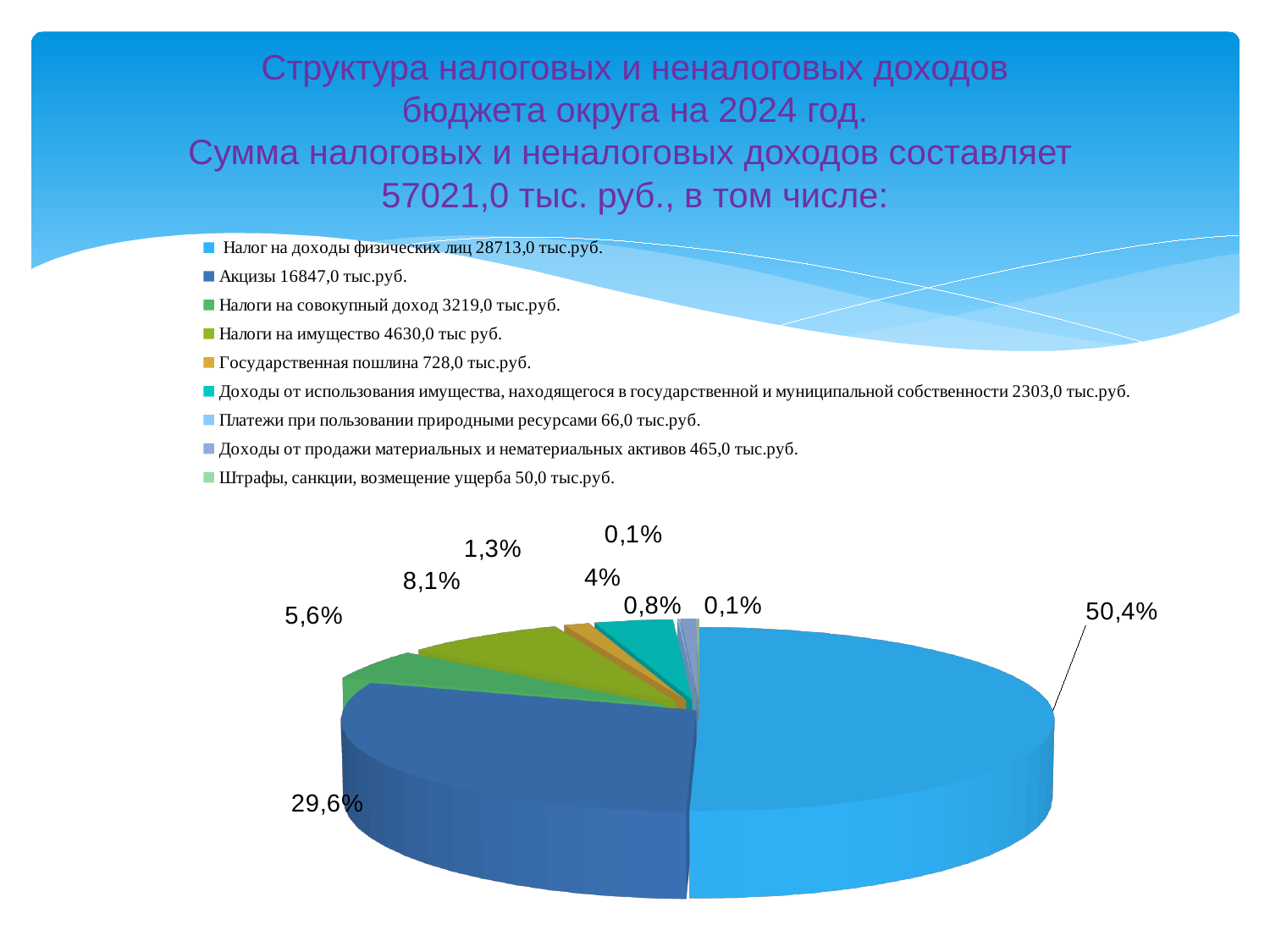
How many categories does the pie chart's legend list? 9 What share of the pie does "Налог на доходы физических лиц" take? 50,4% What is the difference between the legend values for "Налог на доходы физических лиц" and "Акцизы"? 11866,0 тыс.руб. What share of the pie does "Акцизы" take? 29,6% What kind of chart is shown on the slide? pie chart What share of the pie does "Налоги на имущество" take? 8,1% Which is larger: "Налоги на имущество" or "Налоги на совокупный доход"? Налоги на имущество Which category has the largest slice of the pie? Налог на доходы физических лиц According to the slide title, what is the total sum of tax and non-tax revenues? 57021,0 тыс. руб. What value does the legend give for "Штрафы, санкции, возмещение ущерба"? 50,0 тыс.руб. What value does the legend give for "Государственная пошлина"? 728,0 тыс.руб.